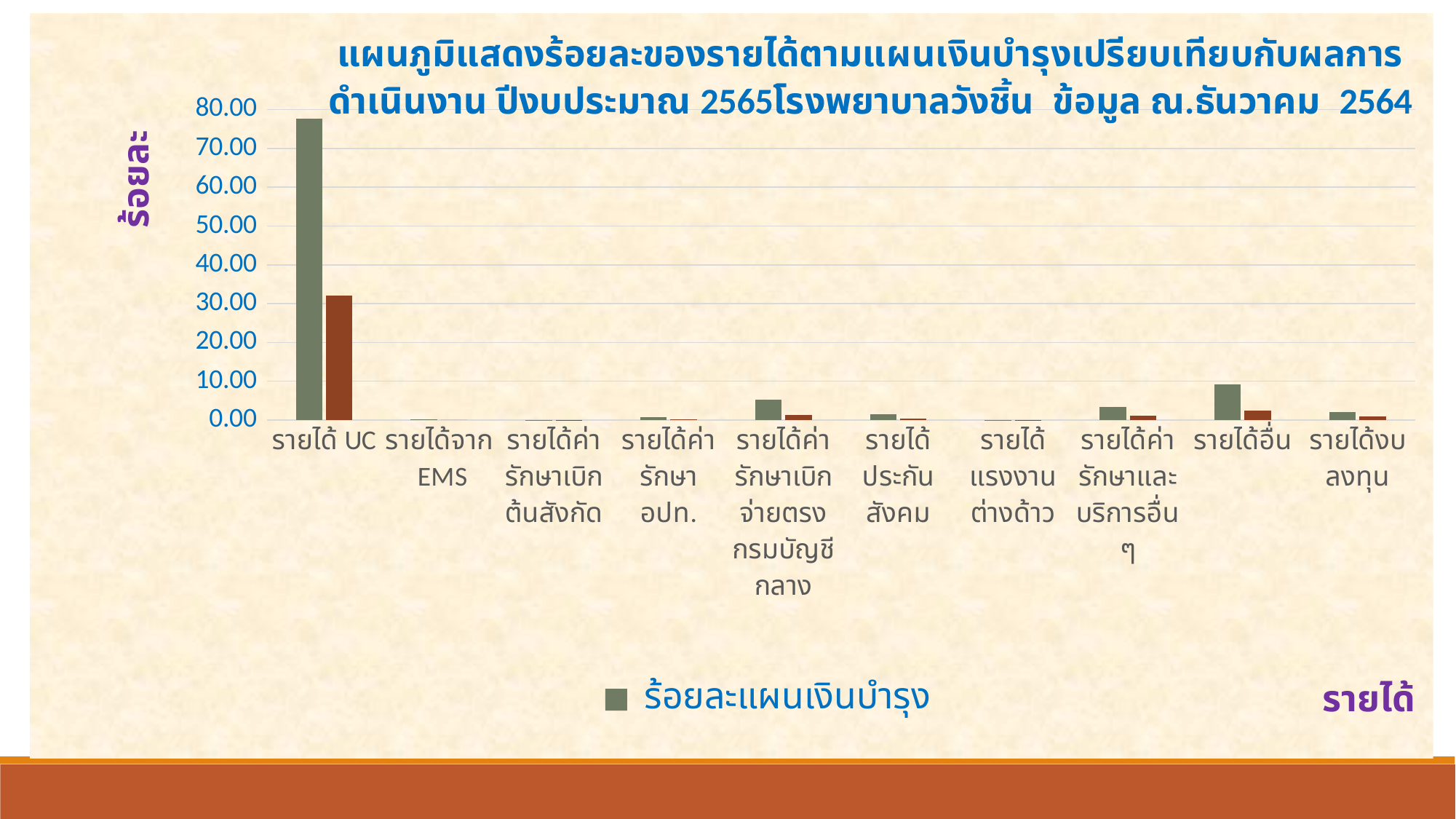
Which category has the highest value for the ร้อยละแผนเงินบำรุง series? รายได้ UC For รายได้อื่น, which bar is taller: the green bar or the brown bar? the green bar What series name is shown in the chart legend? ร้อยละแผนเงินบำรุง For รายได้ UC, which bar is taller: the green ร้อยละแผนเงินบำรุง bar or the brown bar? the green ร้อยละแผนเงินบำรุง bar Is the ร้อยละแผนเงินบำรุง value for รายได้ UC greater or less than 70.00? greater How many categories are shown along the x axis? 10 Which category has a higher ร้อยละแผนเงินบำรุง value: รายได้อื่น or รายได้ประกันสังคม? รายได้อื่น Is the ร้อยละแผนเงินบำรุง value for รายได้ค่ารักษาเบิกจ่ายตรงกรมบัญชีกลาง greater or less than 10.00? less What kind of chart is shown on the slide? bar chart Is the brown bar for รายได้ UC greater or less than 20.00? greater What is the label on the vertical axis of the chart? ร้อยละ